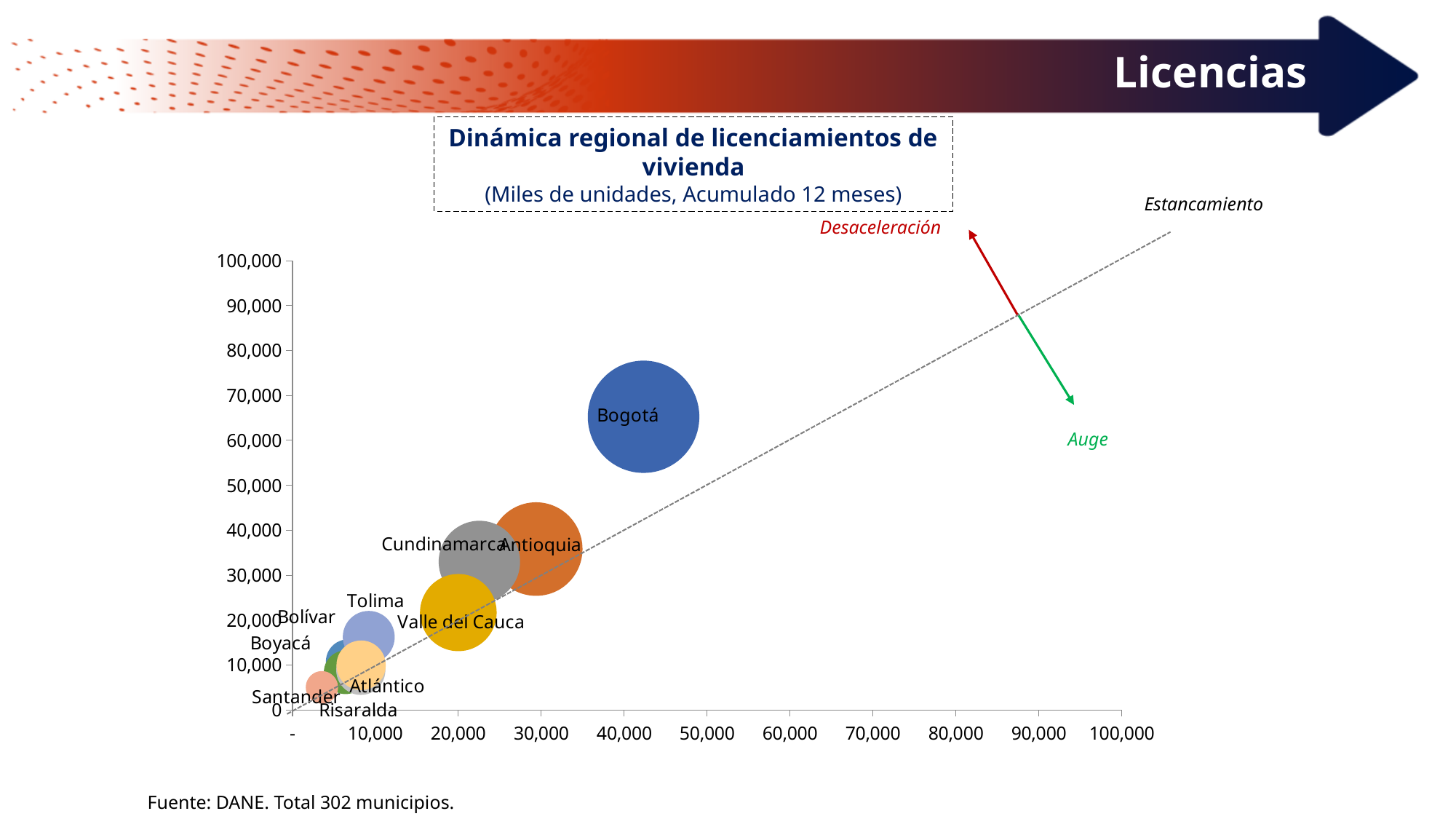
What kind of chart is shown on the slide? Bubble chart What is the maximum value shown on the vertical axis? 100,000 Which region is represented by the largest bubble? Bogotá Which has the higher vertical-axis value, Cundinamarca or Tolima? Cundinamarca Is the vertical-axis value for Antioquia greater or less than 30,000? greater Is the vertical-axis value for Bogotá greater or less than 60,000? greater How many labelled bubbles (regions) are plotted in the chart? 10 Which region has the highest value on the vertical axis? Bogotá Is the vertical-axis value for Valle del Cauca greater or less than 30,000? less Which has the higher vertical-axis value, Bogotá or Antioquia? Bogotá What is the title of the chart? Dinámica regional de licenciamientos de vivienda